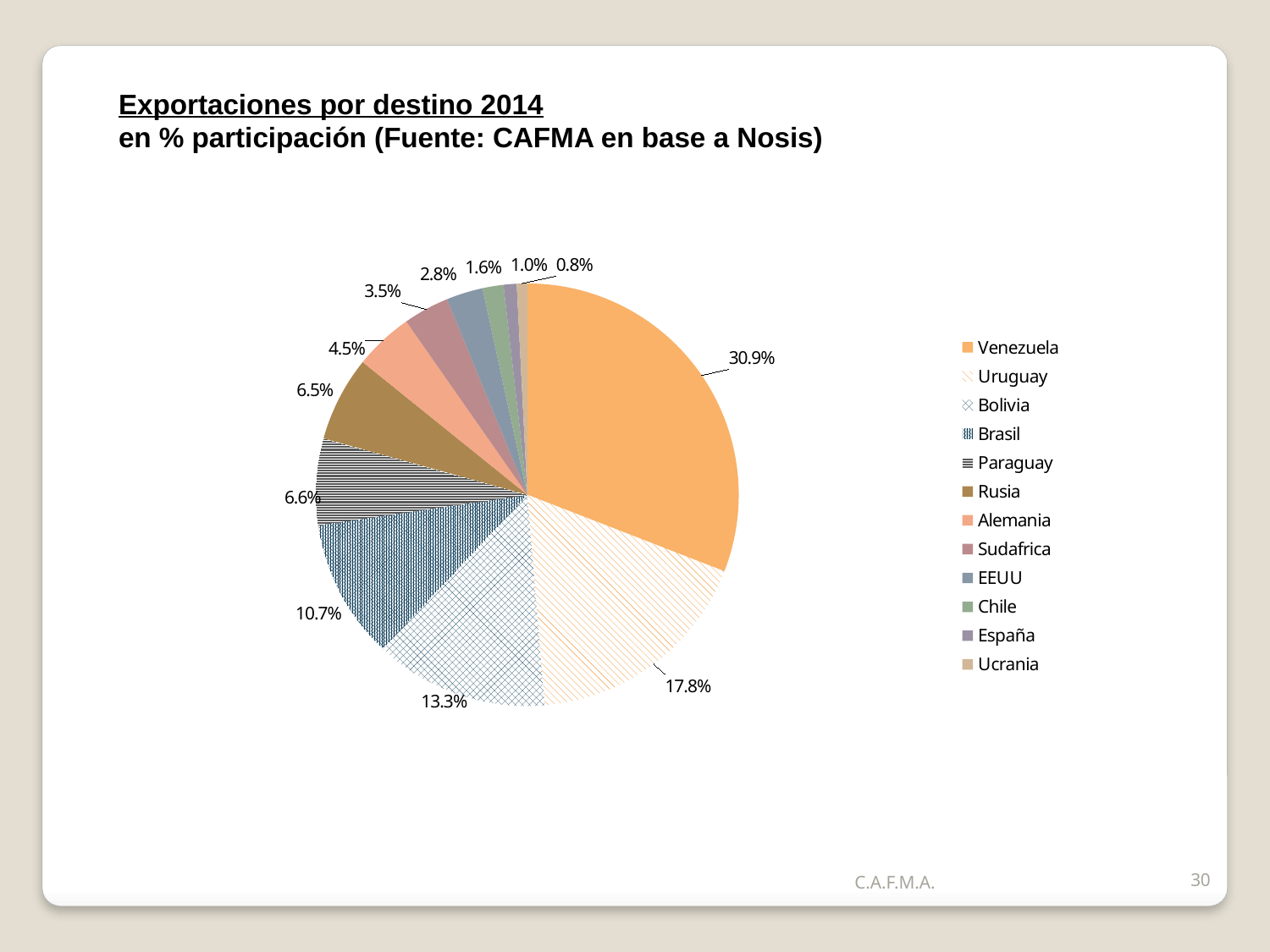
Which has a larger share of exports, Bolivia or Brasil? Bolivia Which destination has the smallest share of exports? Ucrania What share of exports went to Alemania? 4.5% What share of exports went to Brasil? 10.7% What is the title of the chart on the slide? Exportaciones por destino 2014 en % participación (Fuente: CAFMA en base a Nosis) What kind of chart is shown on the slide? Pie chart What share of exports went to Bolivia? 13.3% What is the difference in percentage points between the shares for Venezuela and Uruguay? 13.1 What share of exports went to Venezuela? 30.9% How many destinations are shown in the pie chart? 12 Which destination has the largest share of exports? Venezuela What share of exports went to Uruguay? 17.8%